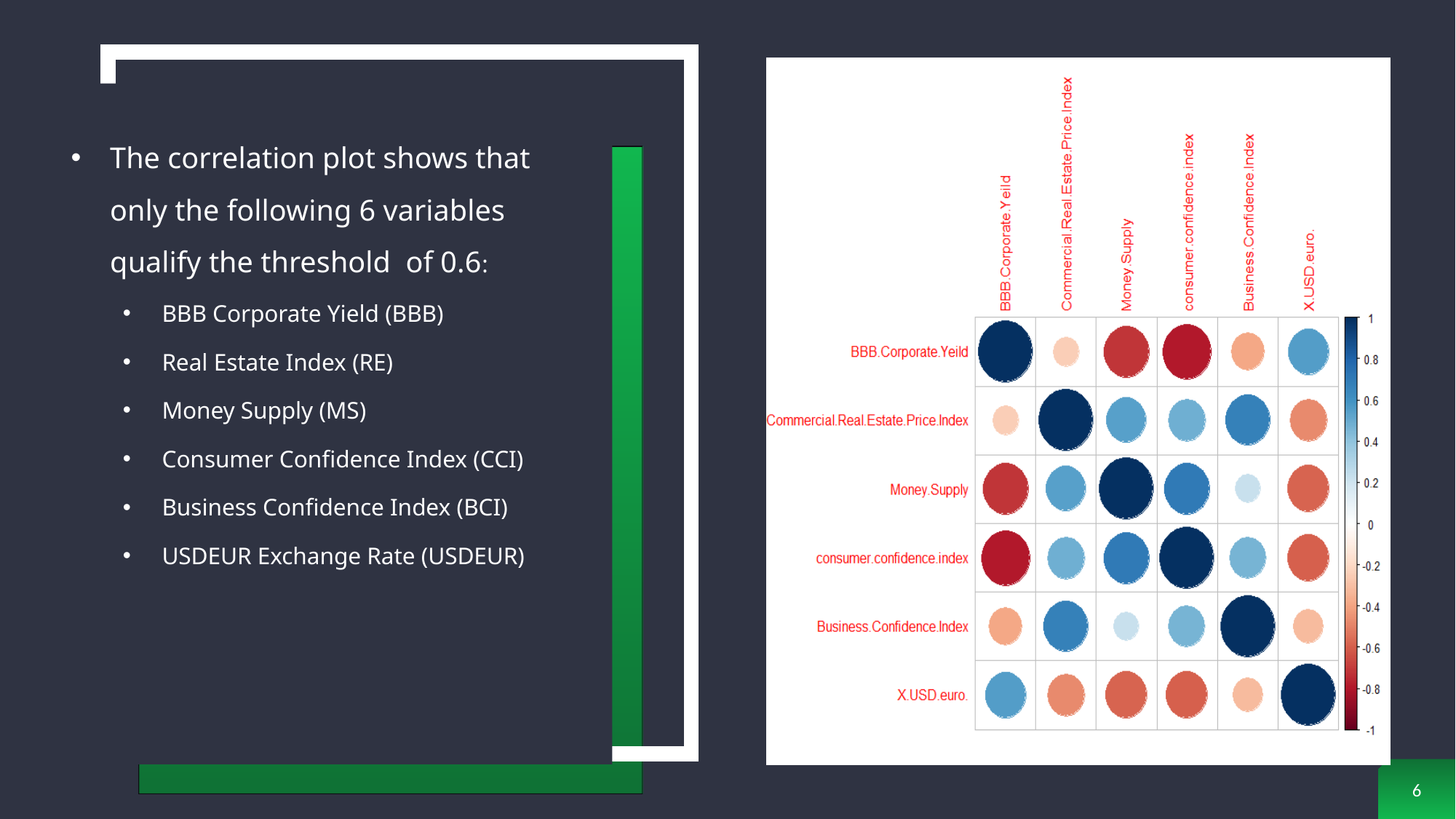
Is the correlation between Business.Confidence.Index and Money.Supply greater or less than 0.6? less Is the correlation between Commercial.Real.Estate.Price.Index and Business.Confidence.Index greater or less than 0? greater What kind of chart is shown on the right of the slide? Correlation plot (correlation matrix) How many variables are included in the correlation plot? 6 Excluding itself, which variable has the strongest negative correlation with BBB.Corporate.Yeild in the correlation plot? consumer.confidence.index Is the correlation between X.USD.euro. and Money.Supply greater or less than 0? less In the correlation plot, which colour indicates a positive correlation? Blue Excluding itself, which variable has the strongest positive correlation with BBB.Corporate.Yeild in the correlation plot? X.USD.euro. What is the range of the colour scale on the right of the correlation plot? -1 to 1